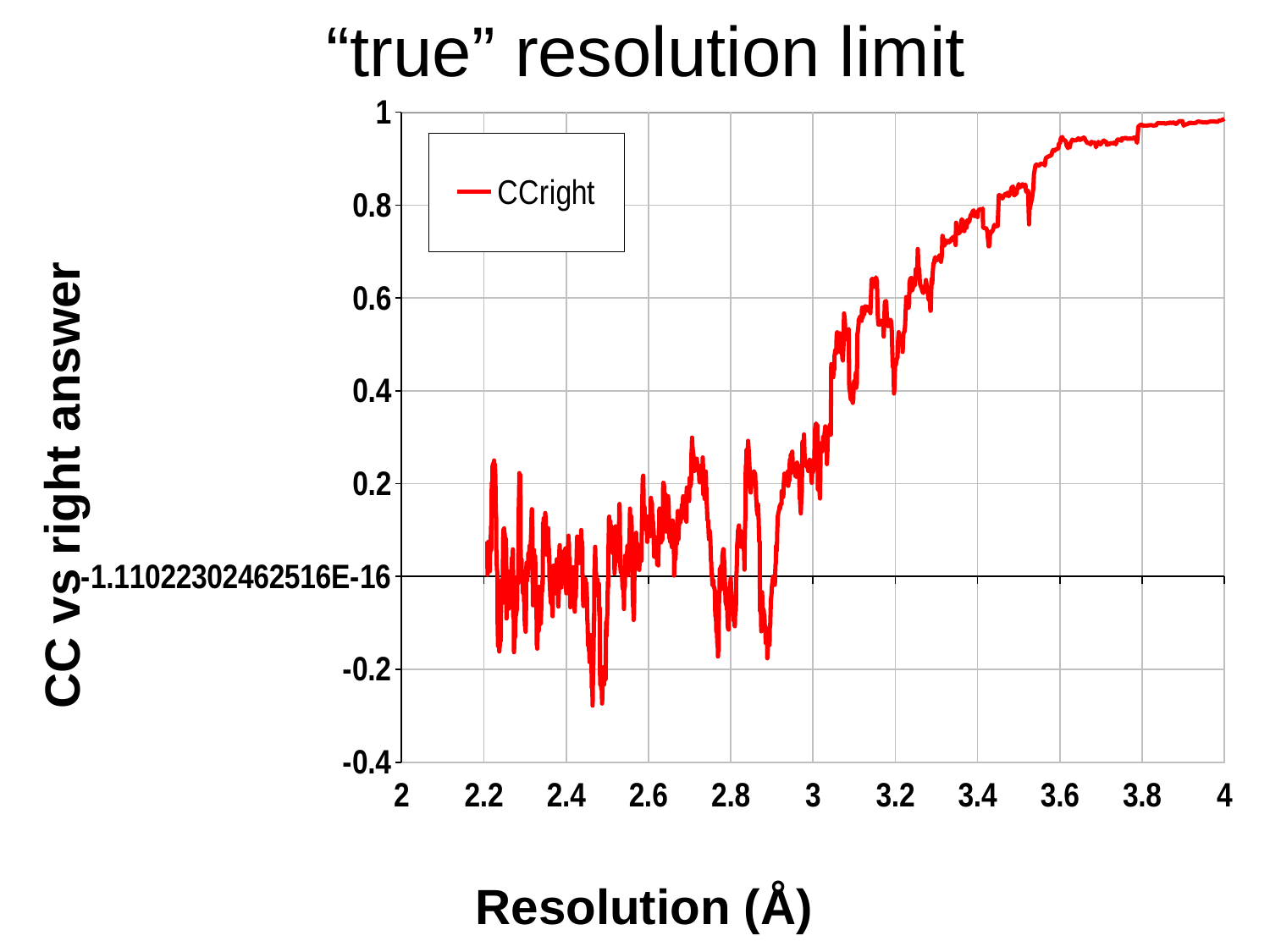
Is the CCright value at a resolution of 2.4 Å greater or less than 0.2? less How many series does the legend list? 1 Is the CCright value higher at a resolution of 3.8 Å or at 2.6 Å? 3.8 Å Overall, does the CCright value rise or fall as resolution increases from 2.2 to 4 Å? Rise Is the CCright value at a resolution of 3.4 Å greater or less than 0.6? greater Is the CCright value at a resolution of 3.6 Å greater or less than 0.8? greater What kind of chart is shown on the slide? Line chart What is the title of the chart? "true" resolution limit What is the name of the series shown in the legend? CCright